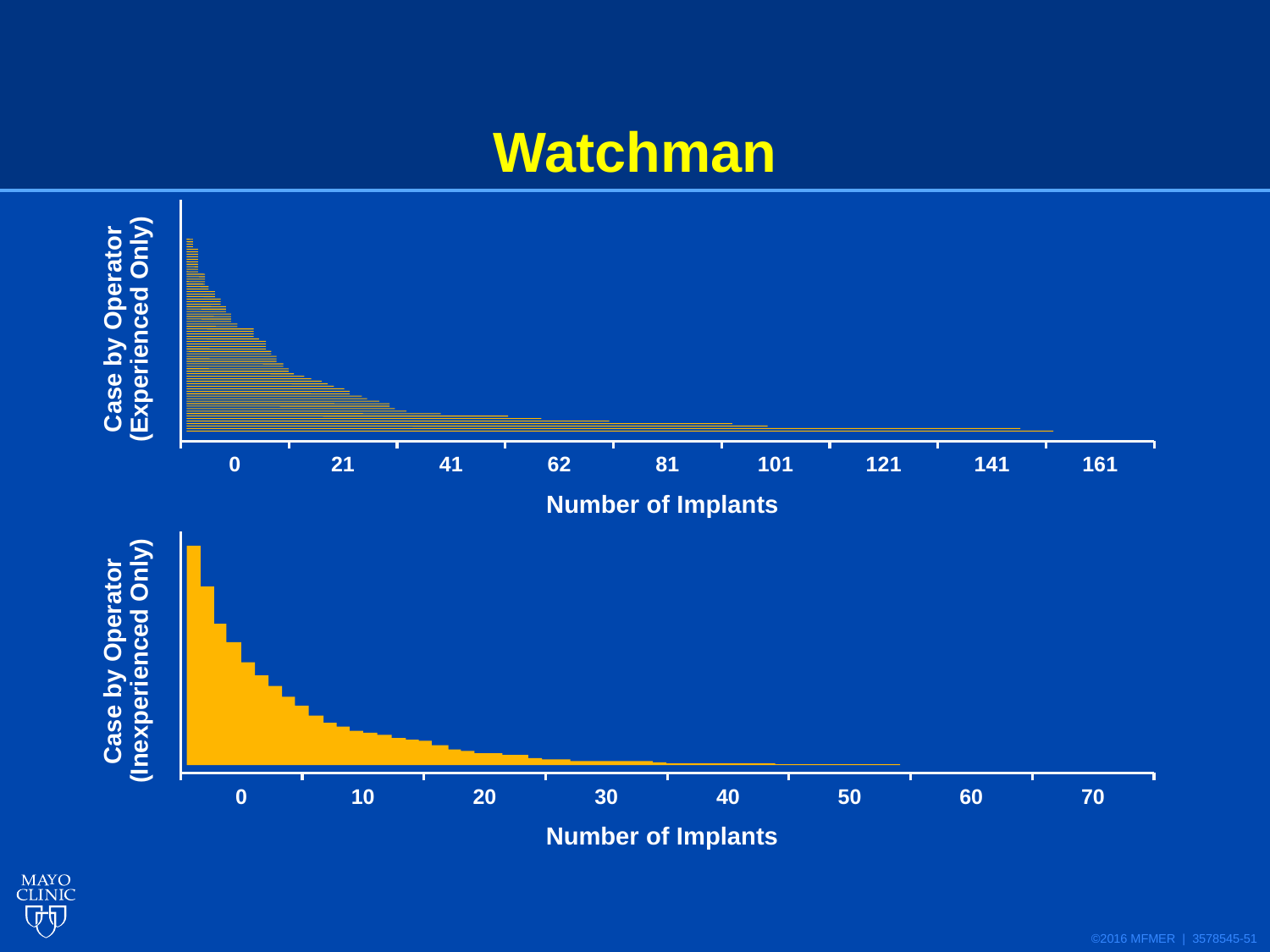
In the bottom chart (Inexperienced Only), do the bar lengths increase or decrease going from the top bar to the bottom bar? increase In the top chart (Experienced Only), is the value of the longest bar greater or less than 161? less What kind of chart is the top chart (Case by Operator, Experienced Only)? bar chart In the bottom chart (Inexperienced Only), is the value of the longest bar greater or less than 40? greater In the bottom chart (Inexperienced Only), is the value of the longest bar greater or less than 50? greater In the top chart (Experienced Only), do the bar lengths increase or decrease going from the bottom bar to the top bar? decrease What is the y-axis label of the bottom chart? Case by Operator (Inexperienced Only) What kind of chart is the bottom chart (Case by Operator, Inexperienced Only)? bar chart What is the x-axis title of the top chart (Experienced Only)? Number of Implants